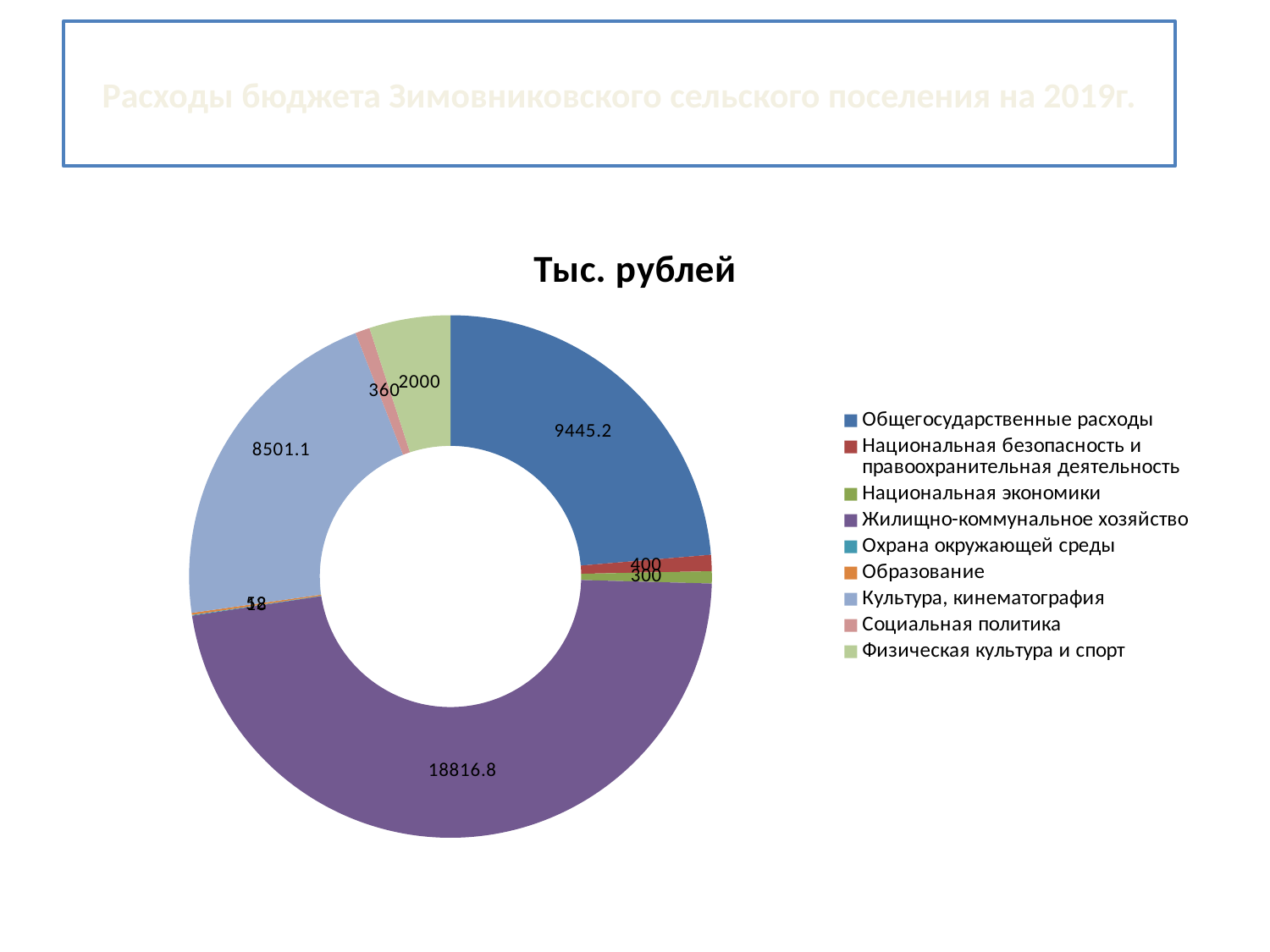
What is the value for Жилищно-коммунальное хозяйство? 18816.8 What is the difference between Культура, кинематография and Физическая культура и спорт? 6501.1 How many categories does the chart legend list? 9 Which category has the largest slice? Жилищно-коммунальное хозяйство What is the value for Общегосударственные расходы? 9445.2 What is the difference between Жилищно-коммунальное хозяйство and Общегосударственные расходы? 9371.6 What is the title of the chart? Тыс. рублей Which is larger, Национальная безопасность и правоохранительная деятельность or Национальная экономики? Национальная безопасность и правоохранительная деятельность What is the value for Культура, кинематография? 8501.1 What kind of chart is shown on the slide? Doughnut (pie) chart What is the value for Социальная политика? 360 What is the value for Физическая культура и спорт? 2000